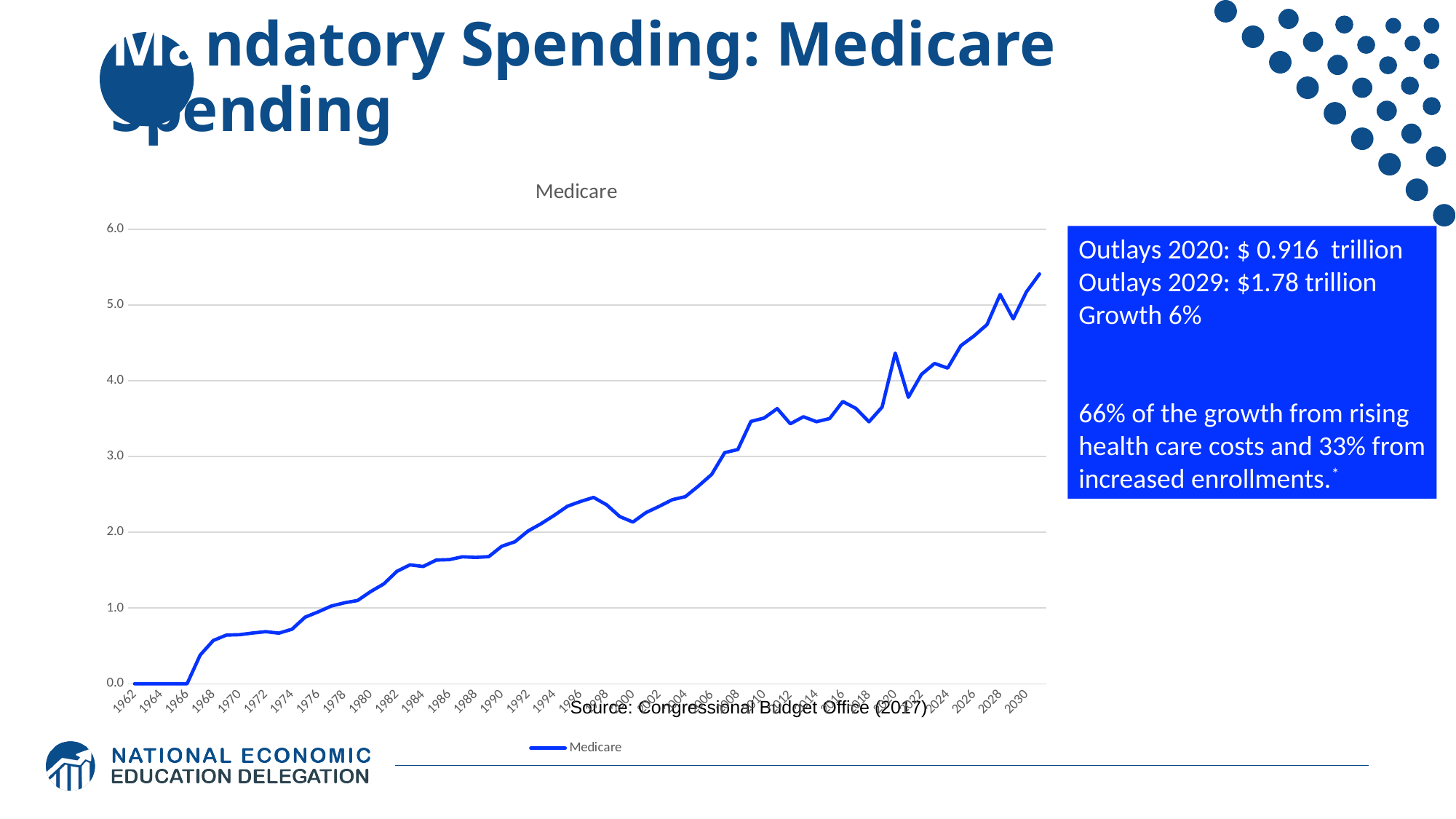
What is the name of the series shown in the chart legend? Medicare Is the value for Medicare in 1990 greater or less than 1.0? greater Is the value for Medicare in 2010 greater or less than 3.0? greater What is the value of the Medicare line in 1962? 0.0 What is the title of the chart? Medicare How many series does the chart legend list? 1 Is the value for Medicare in 1980 greater or less than 2.0? less In which year does the Medicare line reach its highest value? 2031 What kind of chart is shown on the slide? line chart What is the lowest value the Medicare line reaches on the chart? 0.0 Overall, does the Medicare line rise or fall from 1962 to 2030? rise